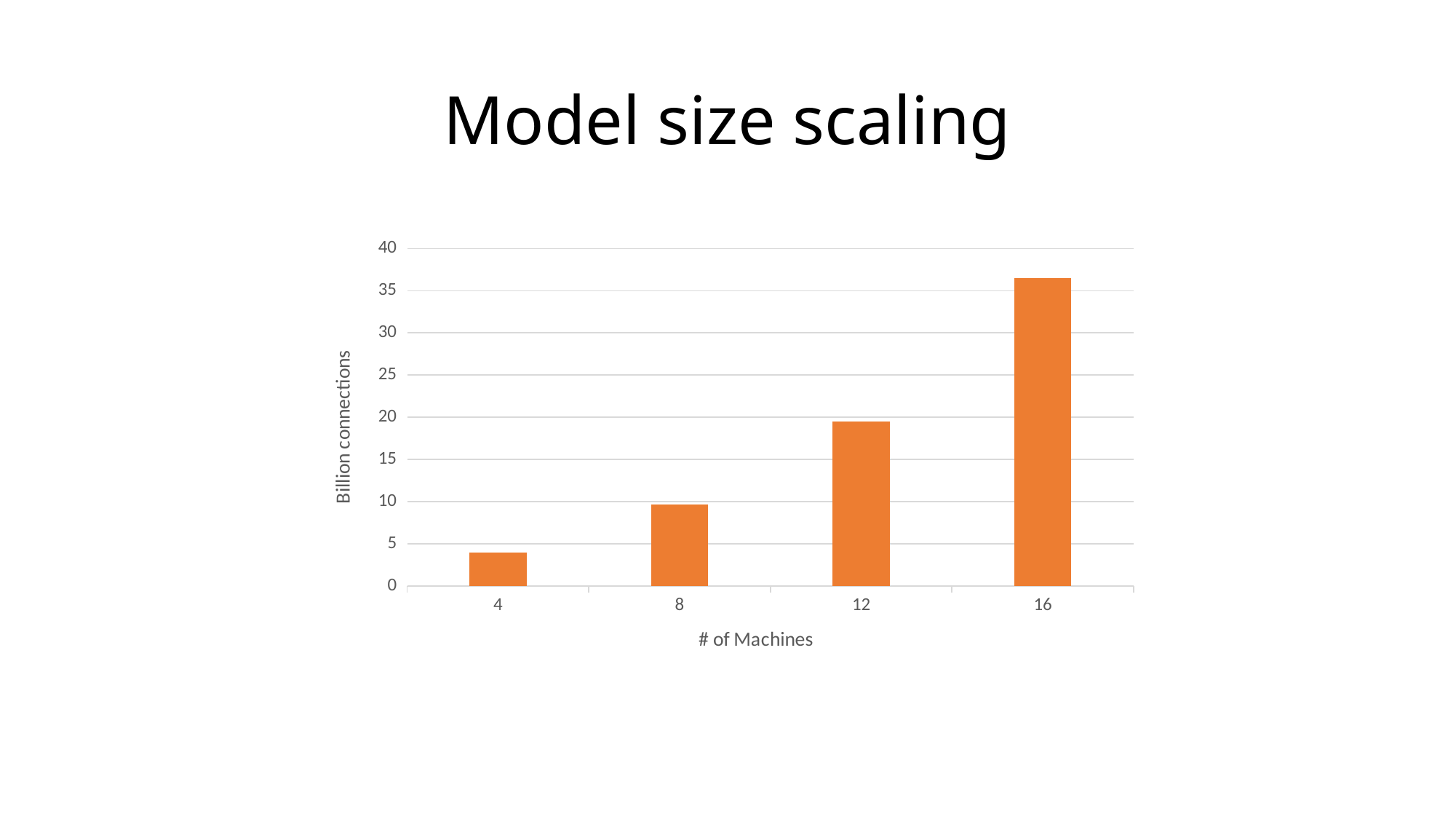
How many bars are plotted in the chart? 4 What kind of chart is shown on the slide? bar chart Which has a larger value, 8 machines or 12 machines? 12 Which number of machines has the highest value for billion connections? 16 Is the value for 16 machines greater or less than 35? greater Which number of machines has the lowest value for billion connections? 4 Is the value for 4 machines greater or less than 5? less What is the label of the x axis? # of Machines What is the label of the y axis? Billion connections Do the values rise or fall as the number of machines increases along the x axis? rise